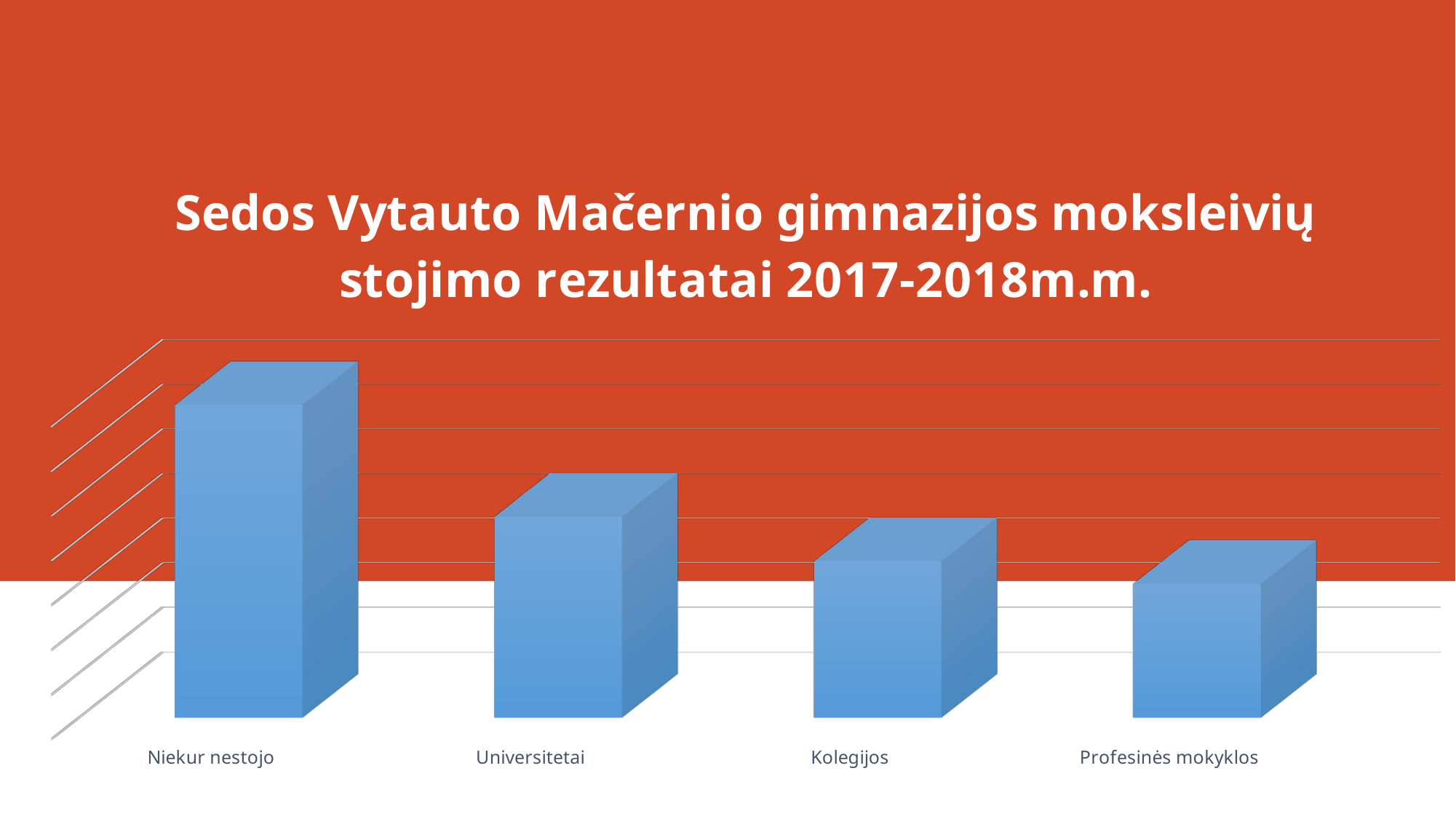
Which is larger, the value for Niekur nestojo or the value for Universitetai? Niekur nestojo What is the label of the second category from the left on the x axis? Universitetai Which category has the lowest bar in the chart? Profesinės mokyklos What is the title of the slide containing the chart? Sedos Vytauto Mačernio gimnazijos moksleivių stojimo rezultatai 2017-2018m.m. How many categories are shown on the x axis of the chart? 4 Do the bar heights rise or fall from left to right along the x axis? fall Which is larger, the value for Kolegijos or the value for Profesinės mokyklos? Kolegijos What colour are the bars in the chart? blue Which is larger, the value for Universitetai or the value for Kolegijos? Universitetai Which category has the highest bar in the chart? Niekur nestojo What kind of chart is shown on the slide? bar chart